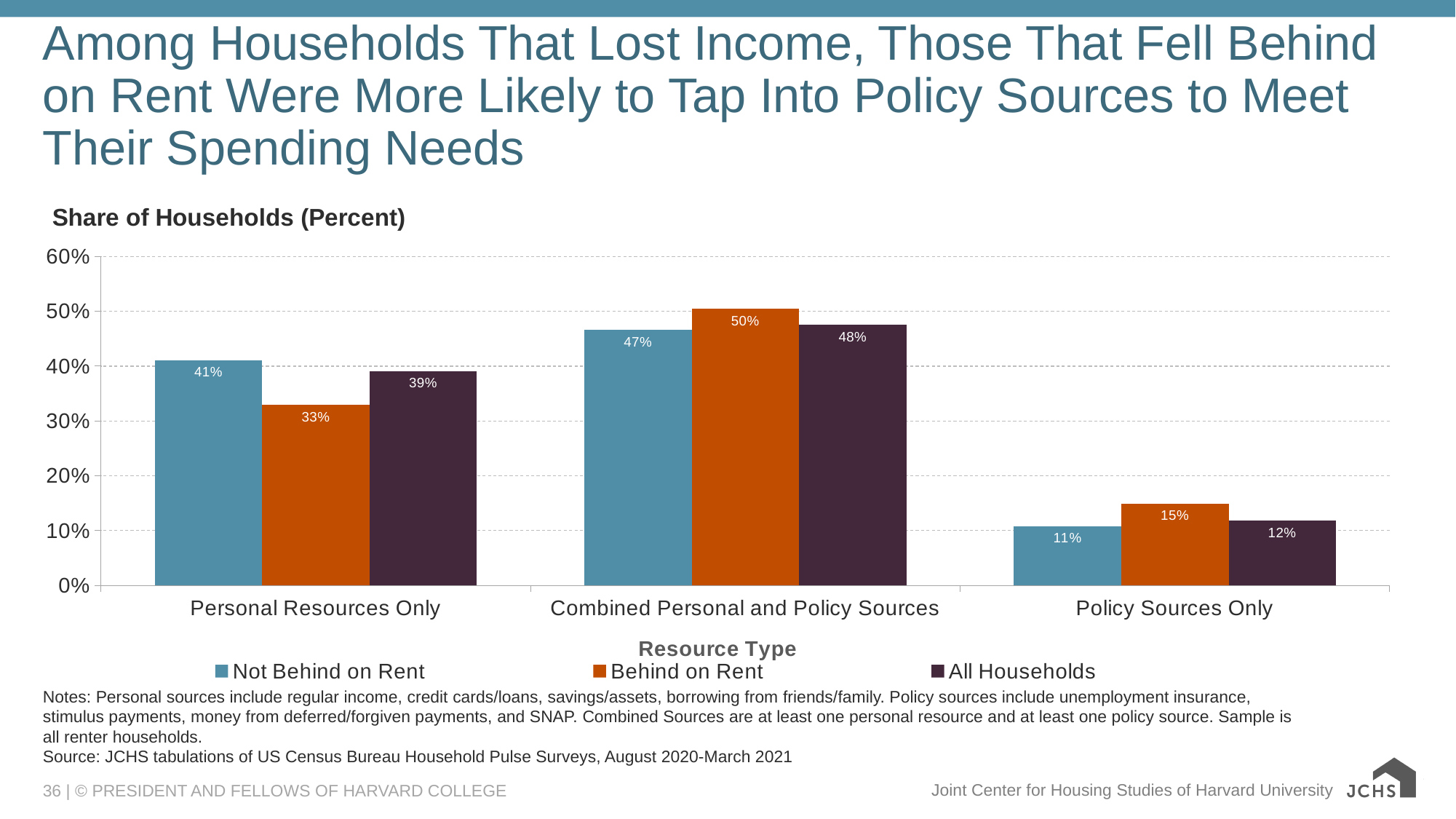
What is the value for Not Behind on Rent in the Policy Sources Only category? 11% Which category has the lowest value for All Households? Policy Sources Only What is the value for Behind on Rent in the Personal Resources Only category? 33% What is the difference between Not Behind on Rent and Behind on Rent in the Personal Resources Only category? 8% What is the value for All Households in the Combined Personal and Policy Sources category? 48% What kind of chart is shown on the slide? Bar chart What is the label of the x axis? Resource Type Which is larger in the Policy Sources Only category: Behind on Rent or Not Behind on Rent? Behind on Rent How many resource type categories are shown on the x axis? 3 Is the value for Behind on Rent in the Combined Personal and Policy Sources category greater or less than 40%? greater Which category has the highest value for Behind on Rent? Combined Personal and Policy Sources How many series does the legend list? 3